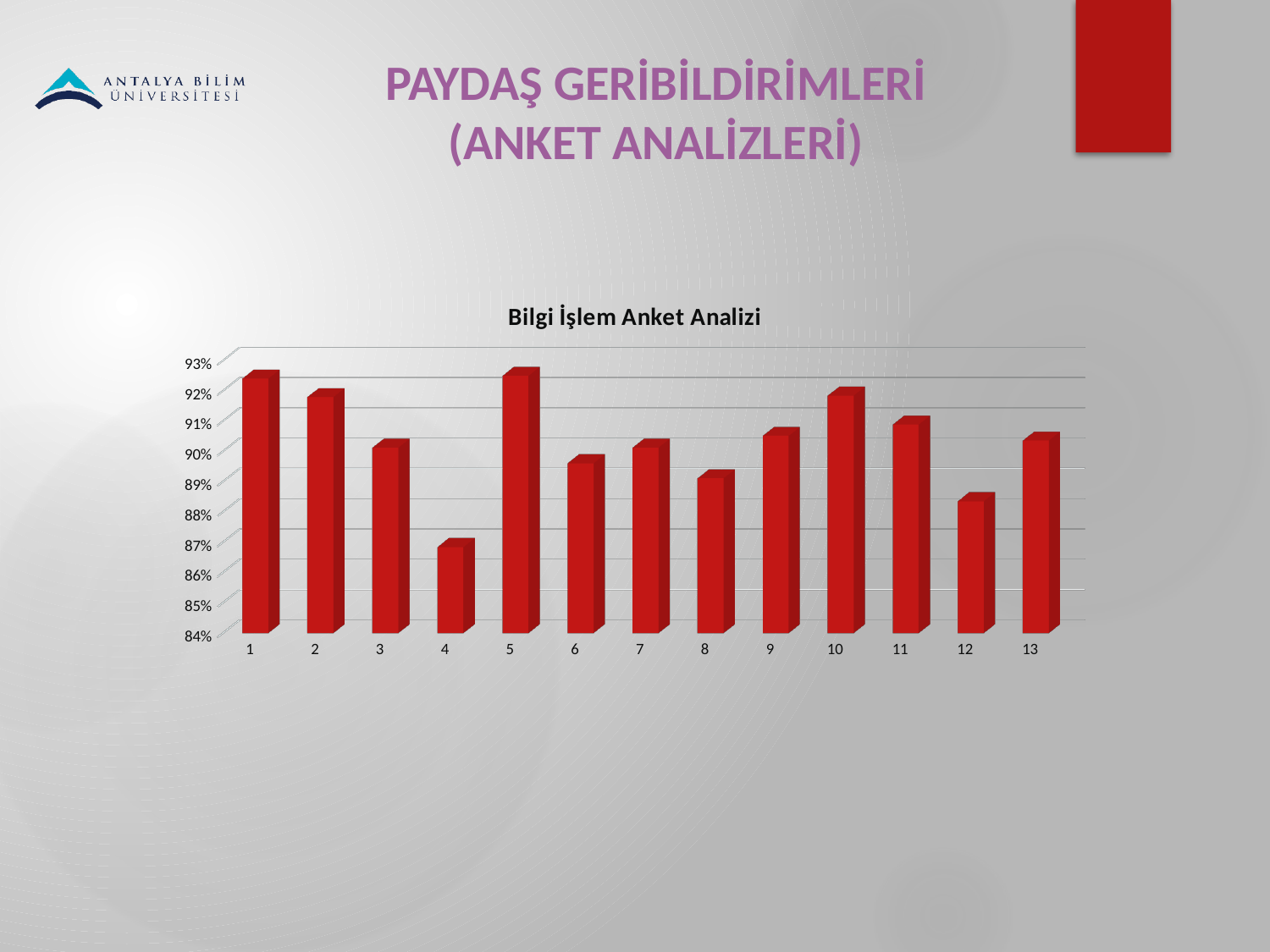
Is the value for category 11 greater or less than 90%? greater Is the value for category 8 greater or less than 90%? less What colour are the bars in the chart? red What kind of chart is shown on the slide? bar chart Is the value for category 4 greater or less than 88%? less What is the title of the chart? Bilgi İşlem Anket Analizi Which category has the lowest value in the chart? 4 How many categories are plotted on the x axis of the chart? 13 Which has the larger value, category 3 or category 12? 3 Which has the larger value, category 4 or category 12? 12